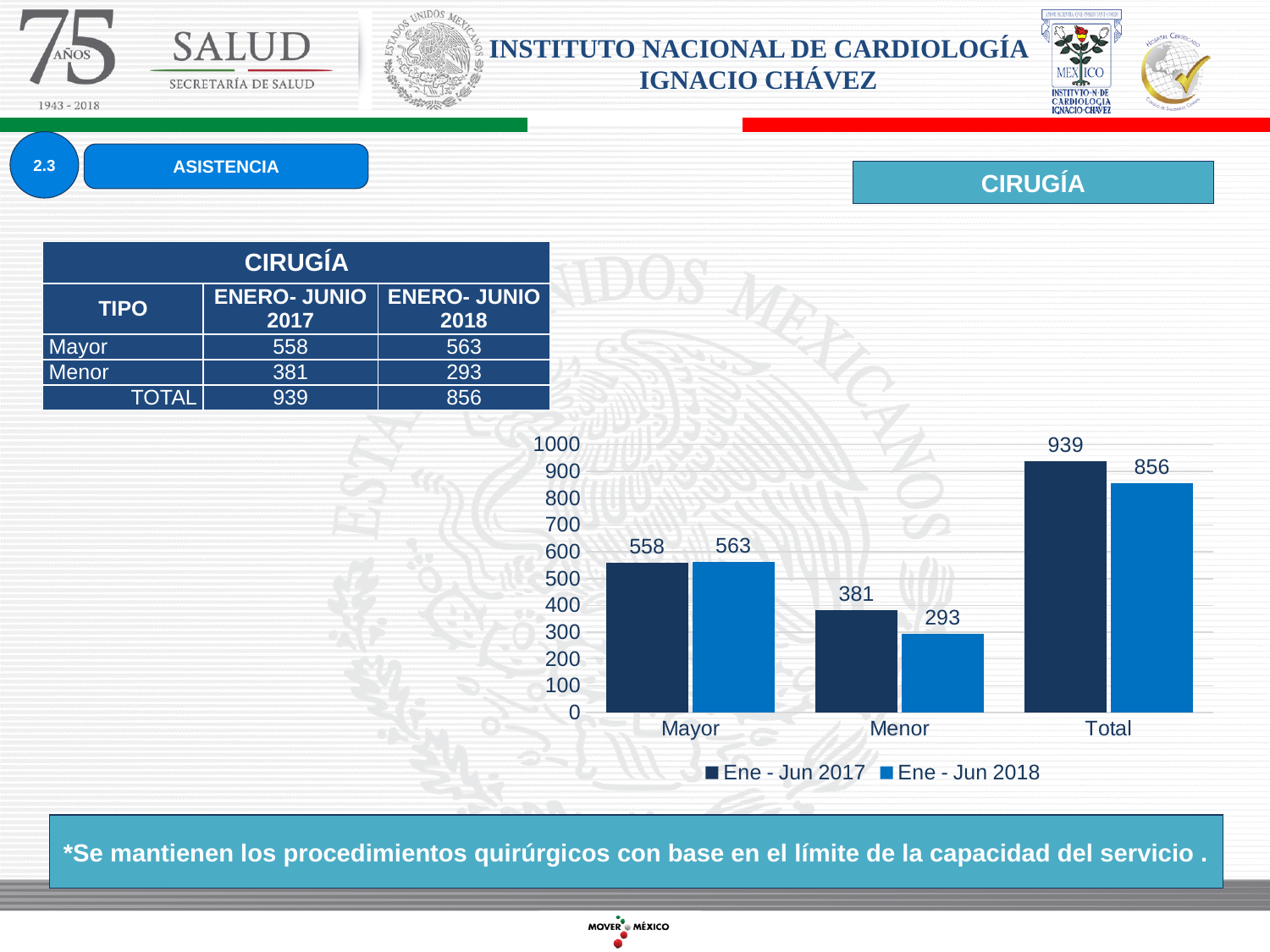
What kind of chart is shown on the slide? Bar chart What is the value for Total in the Ene - Jun 2017 series? 939 What are the two series named in the chart legend? Ene - Jun 2017 and Ene - Jun 2018 Which is larger for Mayor: the Ene - Jun 2017 value or the Ene - Jun 2018 value? Ene - Jun 2018 How many categories are shown on the x axis of the chart? 3 What is the difference between the Ene - Jun 2017 and Ene - Jun 2018 values for Menor? 88 What is the difference between the Total values for Ene - Jun 2017 and Ene - Jun 2018? 83 How many series does the legend list? 2 What is the value for Mayor in the Ene - Jun 2017 series? 558 Which category has the lowest value in the Ene - Jun 2018 series? Menor What is the value for Menor in the Ene - Jun 2018 series? 293 Which category has the highest value in the Ene - Jun 2017 series? Total